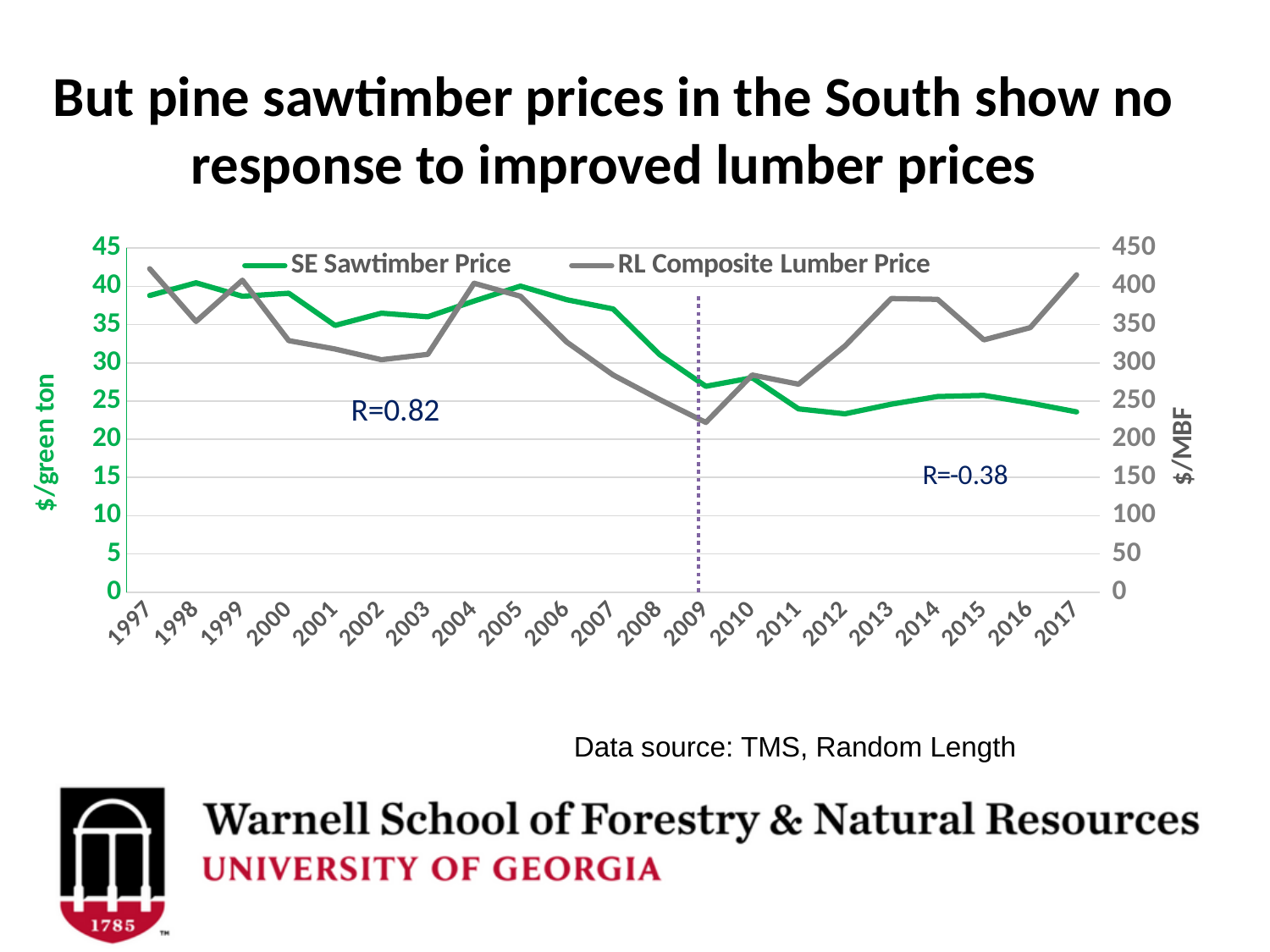
Is the RL Composite Lumber Price value for 2009 greater or less than 250? less Which year has the higher SE Sawtimber Price, 2005 or 2015? 2005 Is the SE Sawtimber Price value for 1998 greater or less than 35? greater Is the SE Sawtimber Price value for 2011 greater or less than 30? less In which year is the RL Composite Lumber Price at its lowest? 2009 How many years are plotted along the x axis? 21 Which series is plotted in green? SE Sawtimber Price How many series does the legend list? 2 Does the SE Sawtimber Price rise or fall from 2005 to 2009? fall What is the label of the right-hand vertical axis? $/MBF What kind of chart is shown on the slide? Line chart